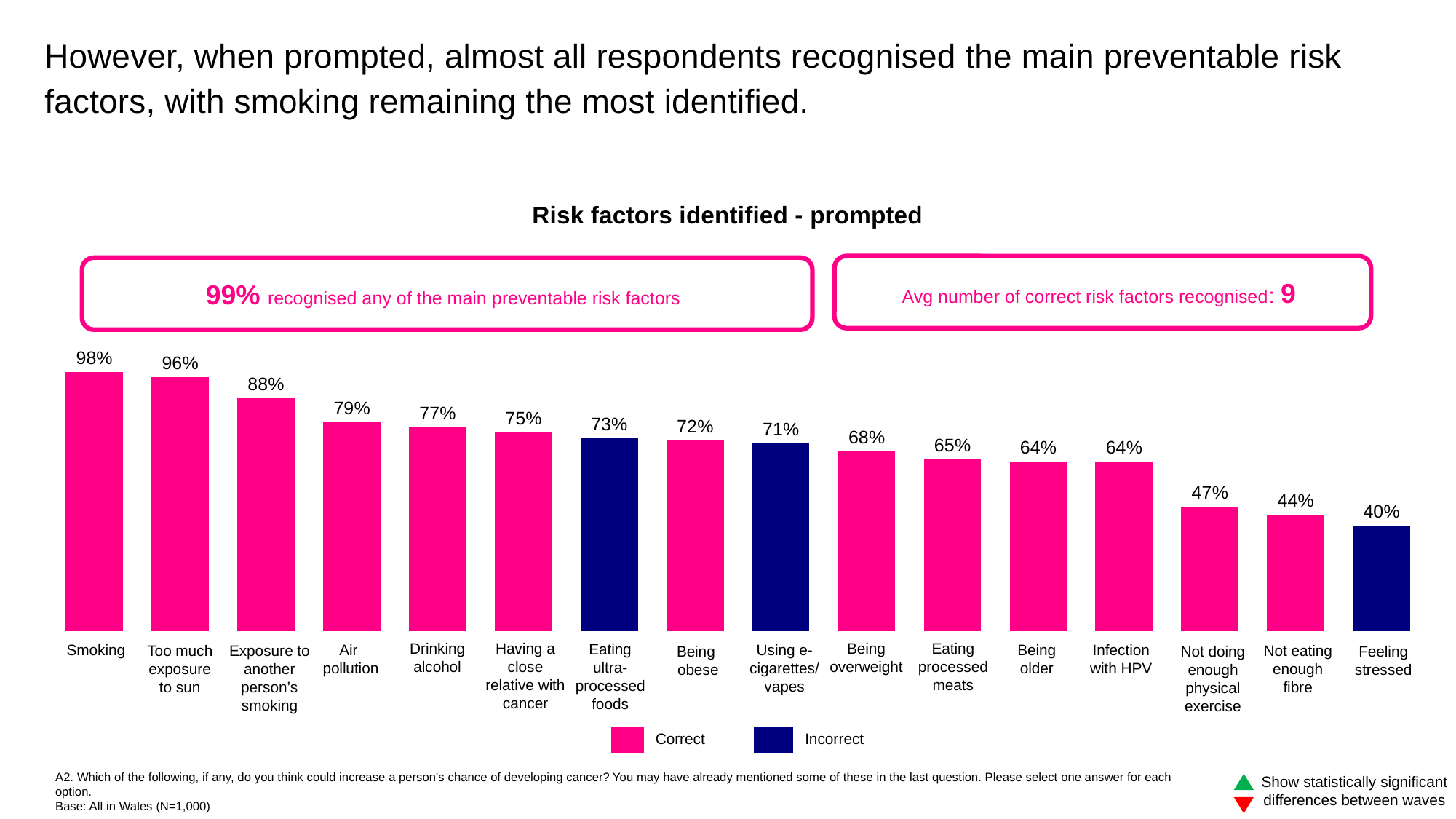
How many risk factors are shown in the chart? 16 How many entries does the legend list? 2 What is the value shown for Infection with HPV? 64% Which has a higher value, Being obese or Being overweight? Being obese What is the difference between the values for Smoking and Feeling stressed? 58% What type of chart is shown on the slide? Bar chart Which risk factor has the lowest percentage? Feeling stressed What percentage is shown for Using e-cigarettes/vapes? 71% Which risk factor has the highest percentage? Smoking What is the title of the chart? Risk factors identified - prompted What percentage of respondents identified Smoking as a risk factor? 98% What is the difference between the values for Air pollution and Drinking alcohol? 2%